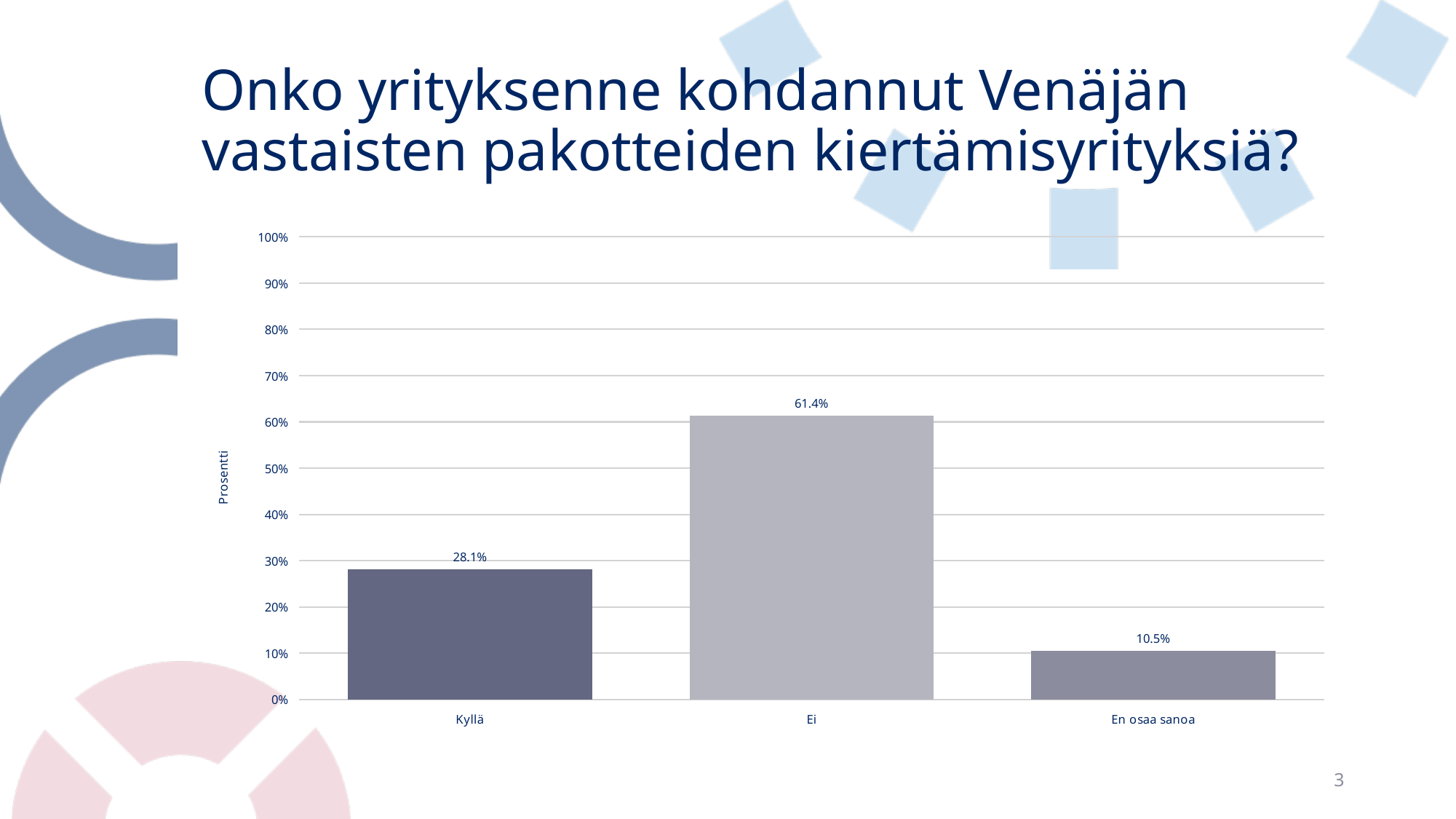
What is the difference between the values for Kyllä and En osaa sanoa? 17.6% What is the difference between the values for Ei and Kyllä? 33.3% Which category has the lowest value? En osaa sanoa How many categories are shown on the x axis? 3 What is the value for Kyllä? 28.1% What is the label of the vertical axis? Prosentti Is the value for Ei greater or less than 50%? greater What kind of chart is shown on the slide? bar chart What is the value for Ei? 61.4% Which is larger, the value for Kyllä or the value for En osaa sanoa? Kyllä Which category has the highest value? Ei What is the value for En osaa sanoa? 10.5%